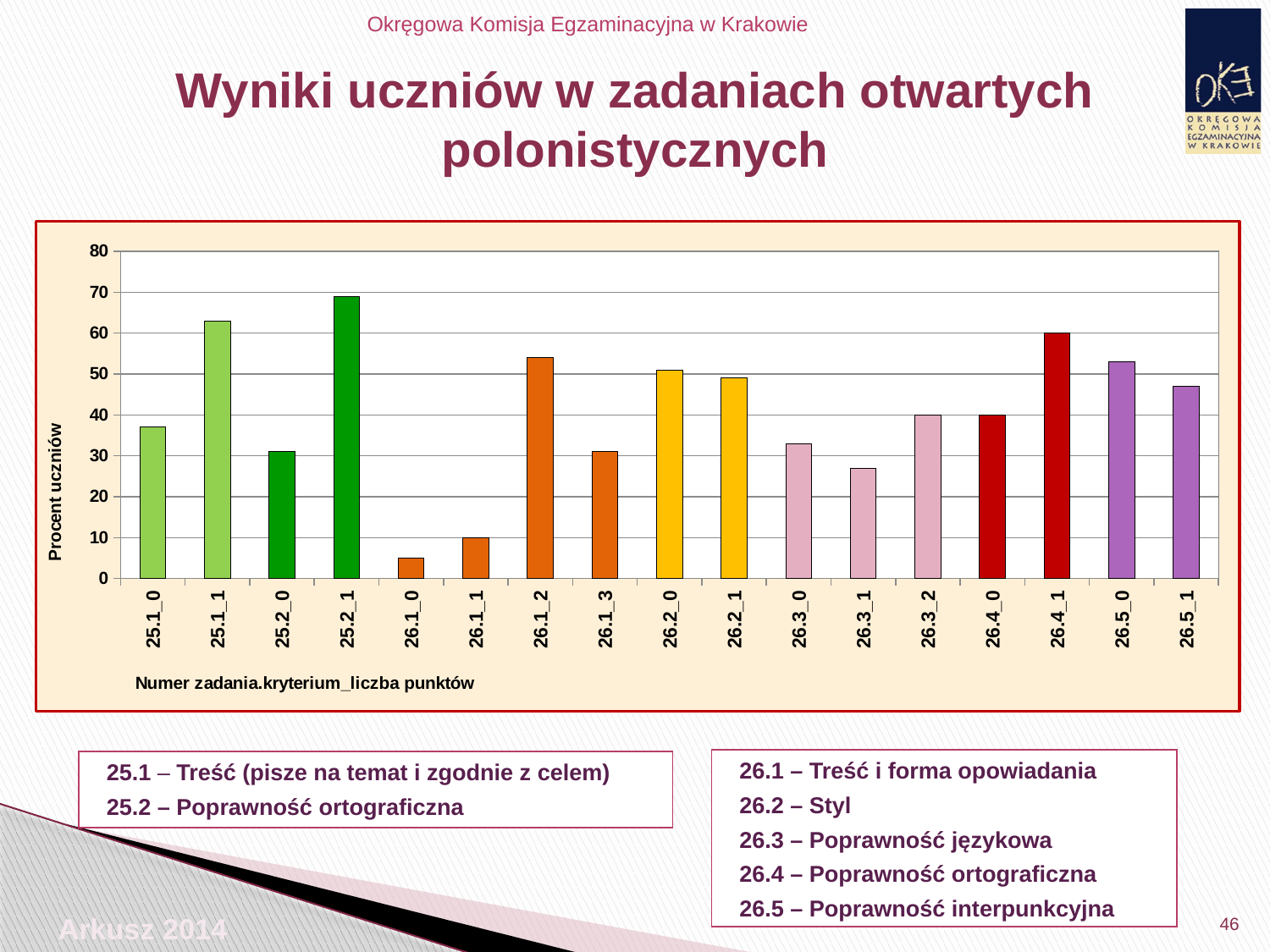
Is the value for 25.1_1 greater or less than 60? greater Is the value for 26.1_2 greater or less than 50? greater Which category has the lowest value? 26.1_0 Is the value for 25.1_0 greater or less than 40? less Which category has the highest value? 25.2_1 What kind of chart is shown on the slide? bar chart What is the title of the y axis? Procent uczniów Which is larger, the value for 26.1_2 or the value for 26.1_3? 26.1_2 What label is shown under the x axis? Numer zadania.kryterium_liczba punktów How many categories (bars) are plotted on the x axis? 17